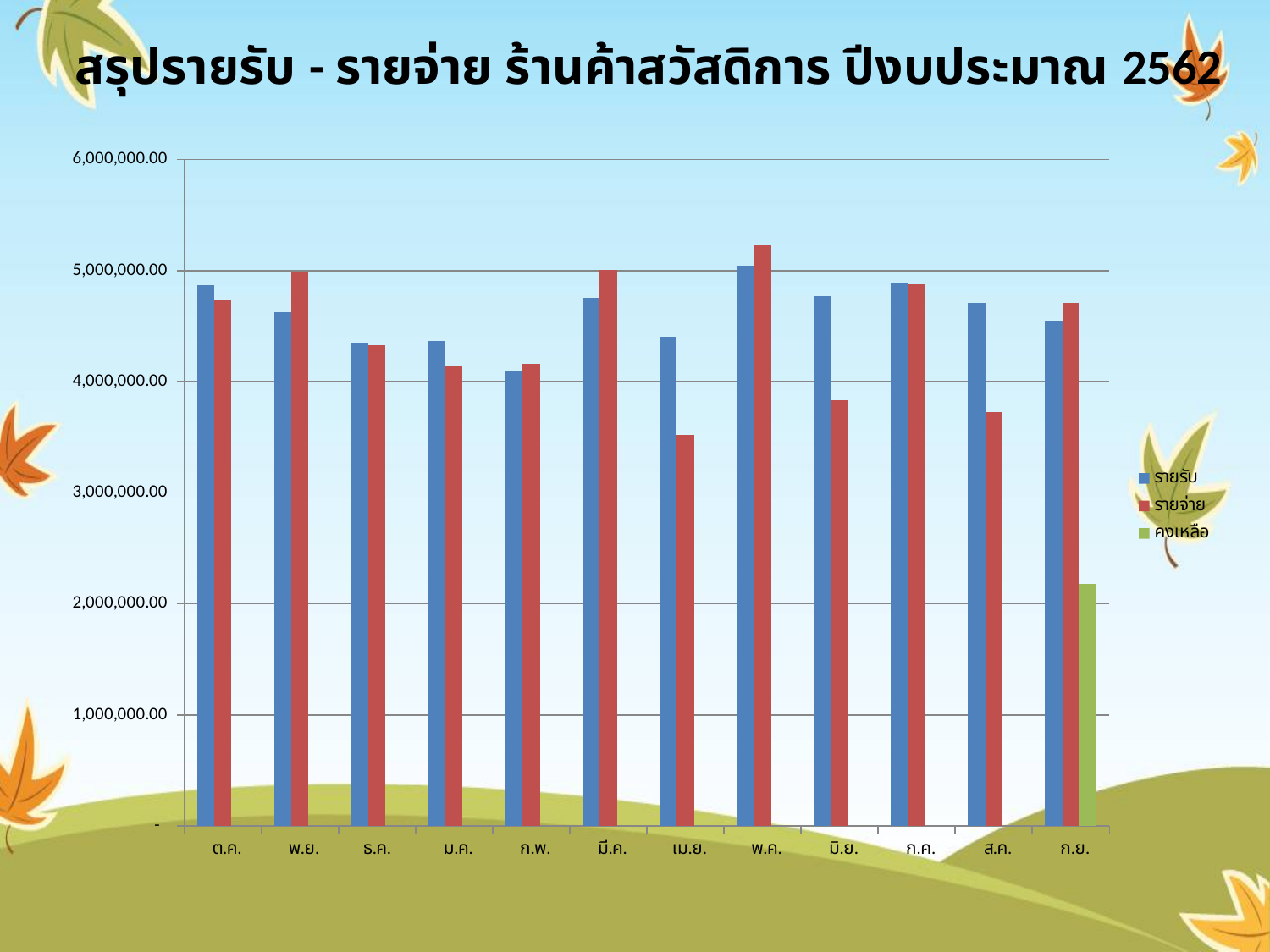
Is the รายจ่าย value for พ.ค. greater or less than 5,000,000.00? greater Which month has the highest รายรับ value? พ.ค. Is the คงเหลือ value for ก.ย. greater or less than 2,000,000.00? greater Is the รายจ่าย value for ส.ค. greater or less than 4,000,000.00? less How many series does the chart legend list? 3 How many months are shown on the x axis of the chart? 12 What kind of chart is shown on the slide? bar chart In มี.ค., which is larger: รายรับ or รายจ่าย? รายจ่าย In เม.ย., which is larger: รายรับ or รายจ่าย? รายรับ In which month does the คงเหลือ (green) bar appear? ก.ย. Which month has the lowest รายจ่าย value? เม.ย. Which month has the lowest รายรับ value? ก.พ.